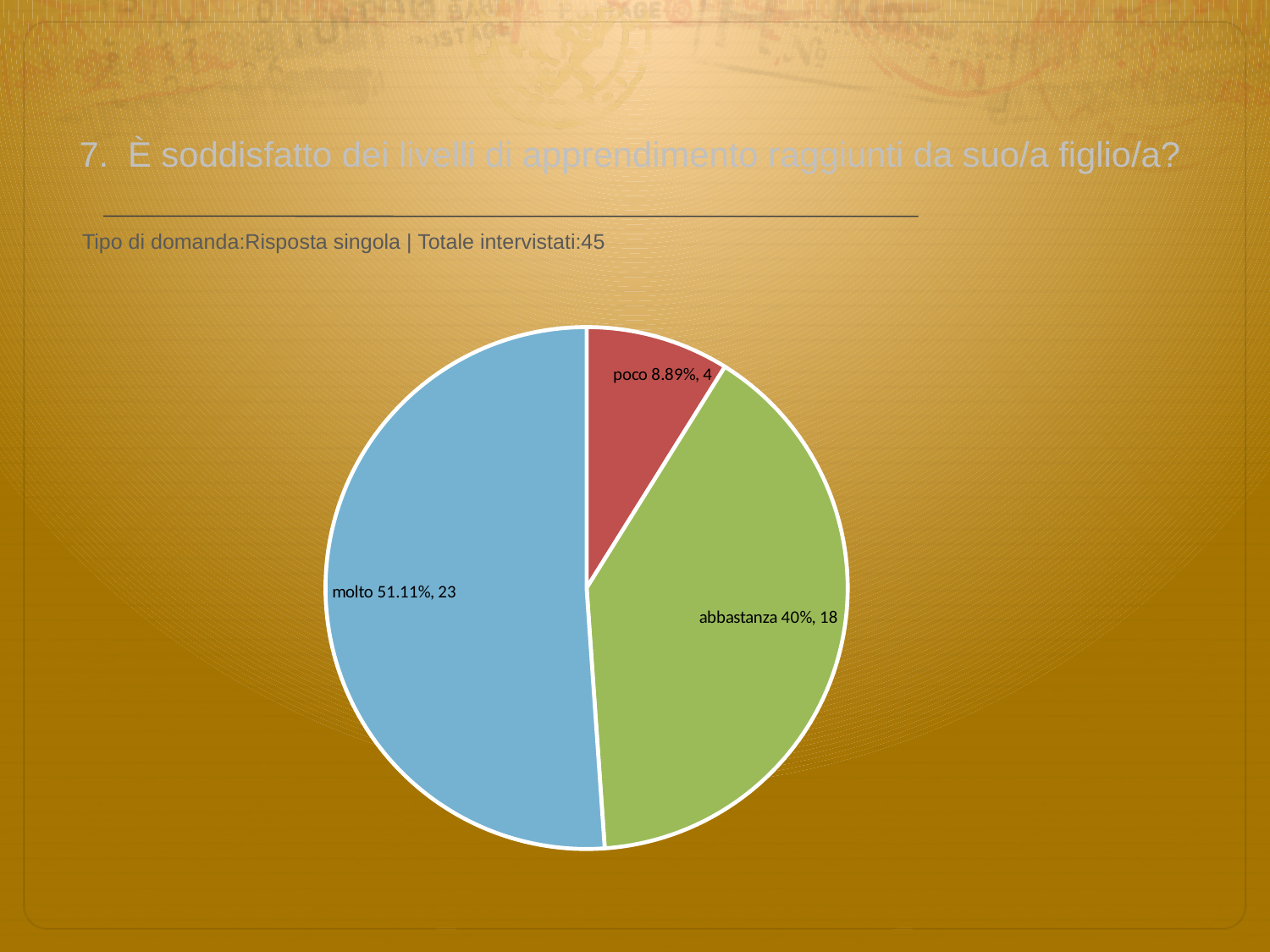
How many respondents answered 'abbastanza'? 18 What kind of chart is shown on the slide? pie chart Which response has the largest slice of the pie? molto What percentage share does the 'molto' slice have? 51.11% Which response has the smallest slice of the pie? poco What percentage share does the 'poco' slice have? 8.89% What percentage share does the 'abbastanza' slice have? 40% How many slices does the pie chart have? 3 What is the difference in respondent count between 'molto' and 'abbastanza'? 5 How many respondents answered 'poco'? 4 How many respondents answered 'molto'? 23 Which slice is larger, 'abbastanza' or 'poco'? abbastanza